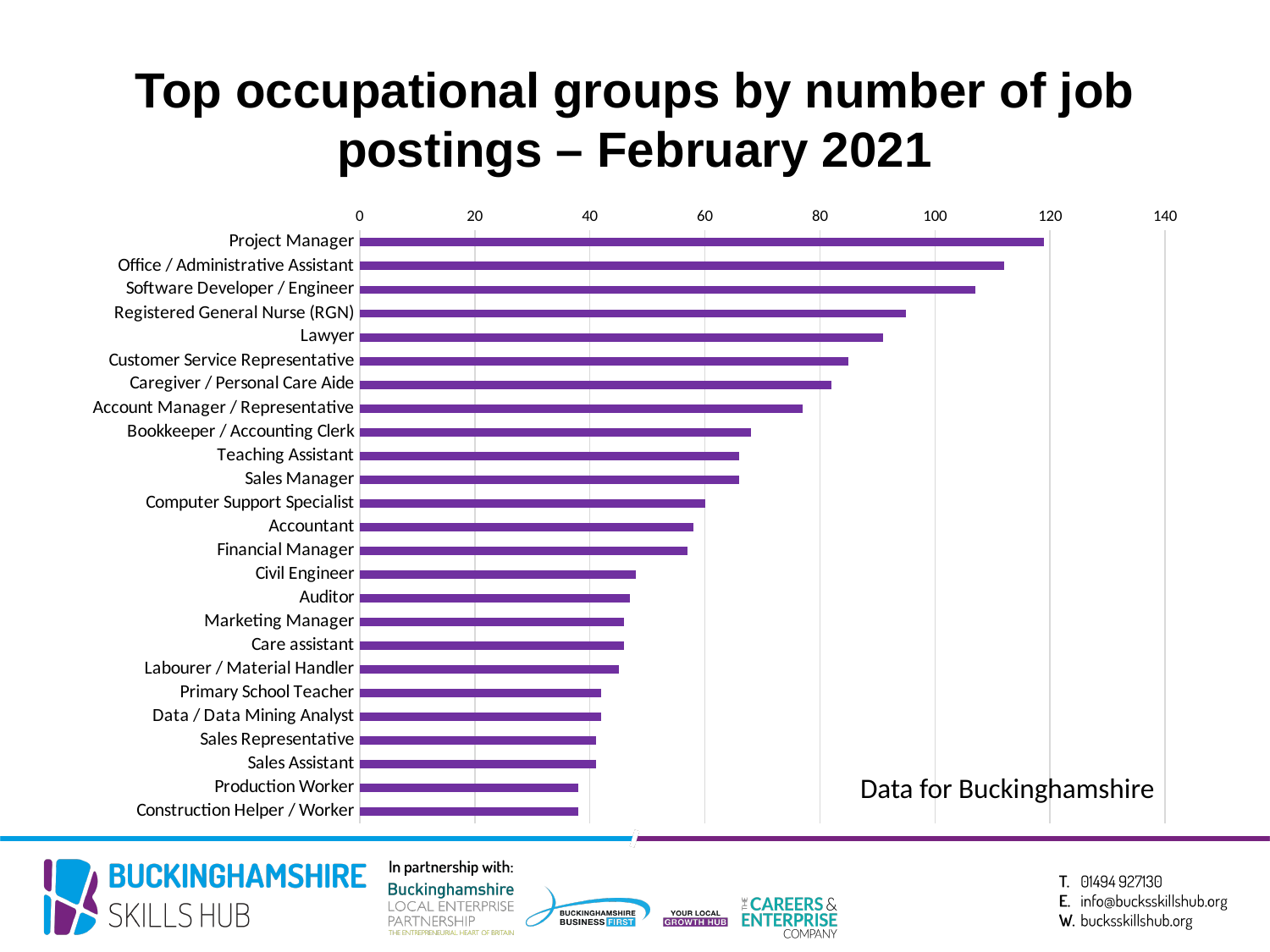
Is the value for Registered General Nurse (RGN) greater or less than 100? less How many occupational groups are listed on the chart? 25 Is the value for Bookkeeper / Accounting Clerk greater or less than 60? greater Is the value for Project Manager greater or less than 100? greater What kind of chart is shown on the slide? Bar chart Which occupational group has the highest number of job postings? Project Manager Which has more job postings, Lawyer or Accountant? Lawyer What is the title of the chart on the slide? Top occupational groups by number of job postings – February 2021